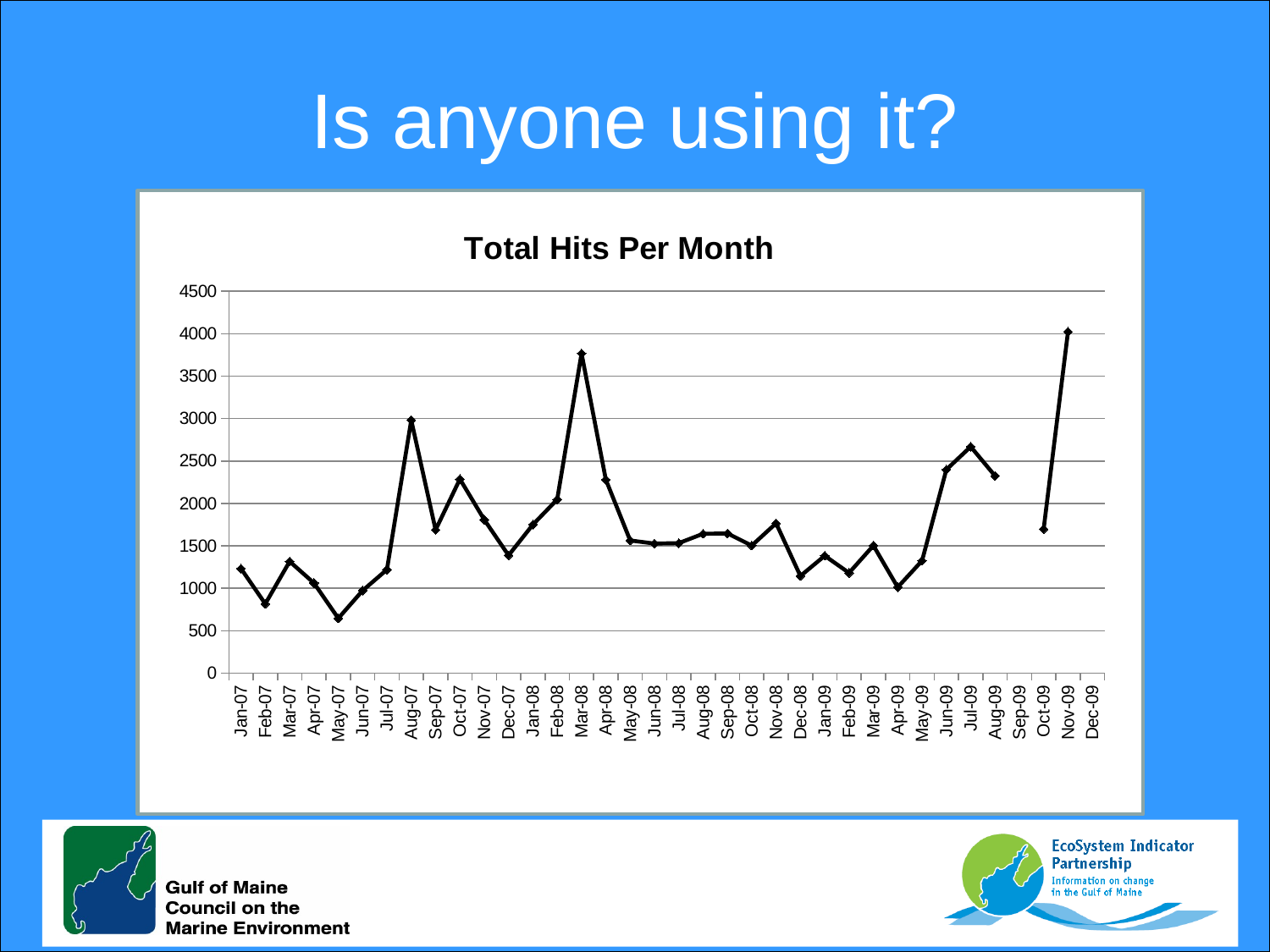
Which is larger, the value for Aug-07 or the value for Oct-07? Aug-07 Which month has the highest value on the chart? Nov-09 What kind of chart is shown on the slide? line chart Is the value for Aug-07 greater or less than 2500? greater Is the value for Jun-09 greater or less than 2000? greater Is the value for Mar-08 greater or less than 3500? greater Which month has the lowest value on the chart? May-07 Do the values rise or fall from Mar-08 to May-08? fall What is the title of the chart? Total Hits Per Month Which is larger, the value for Jul-09 or the value for Aug-09? Jul-09